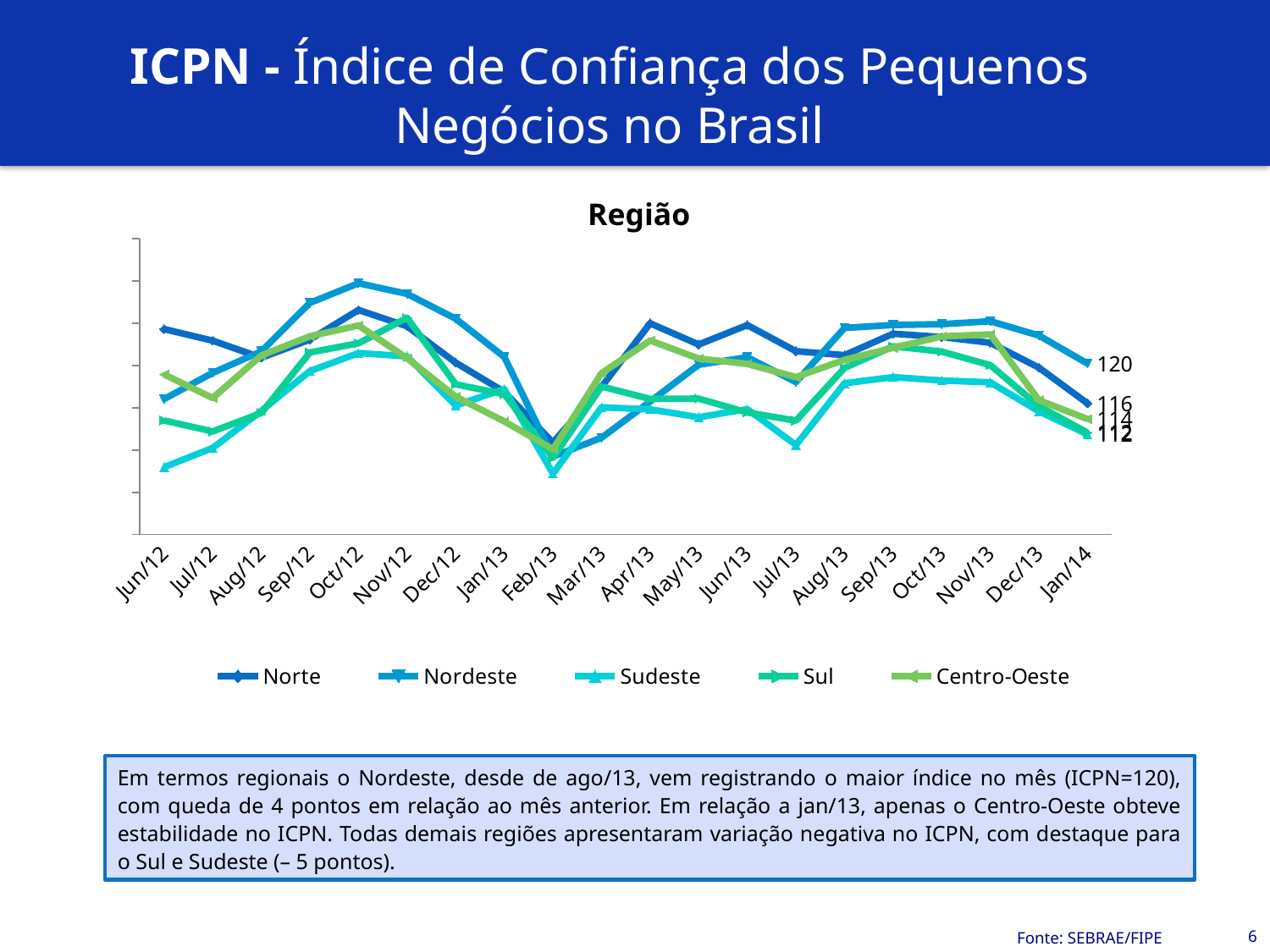
What is the difference between the Nordeste and Norte values in Jan/14? 4 Does the Sudeste series rise or fall from Jun/12 to Oct/12? rise What kind of chart is shown on the slide? line chart How many series does the legend of the "Região" chart list? 5 How many months are plotted along the x axis of the chart? 20 What is the value of the Nordeste series in Jan/14? 120 What is the value of the Norte series in Jan/14? 116 Which region has the lowest value in Jun/12? Sudeste What is the title of the chart? Região In Jan/14, which is larger: the Nordeste value or the Norte value? Nordeste Which region has the highest value in Jan/14? Nordeste Which region has the highest value in Oct/12? Nordeste